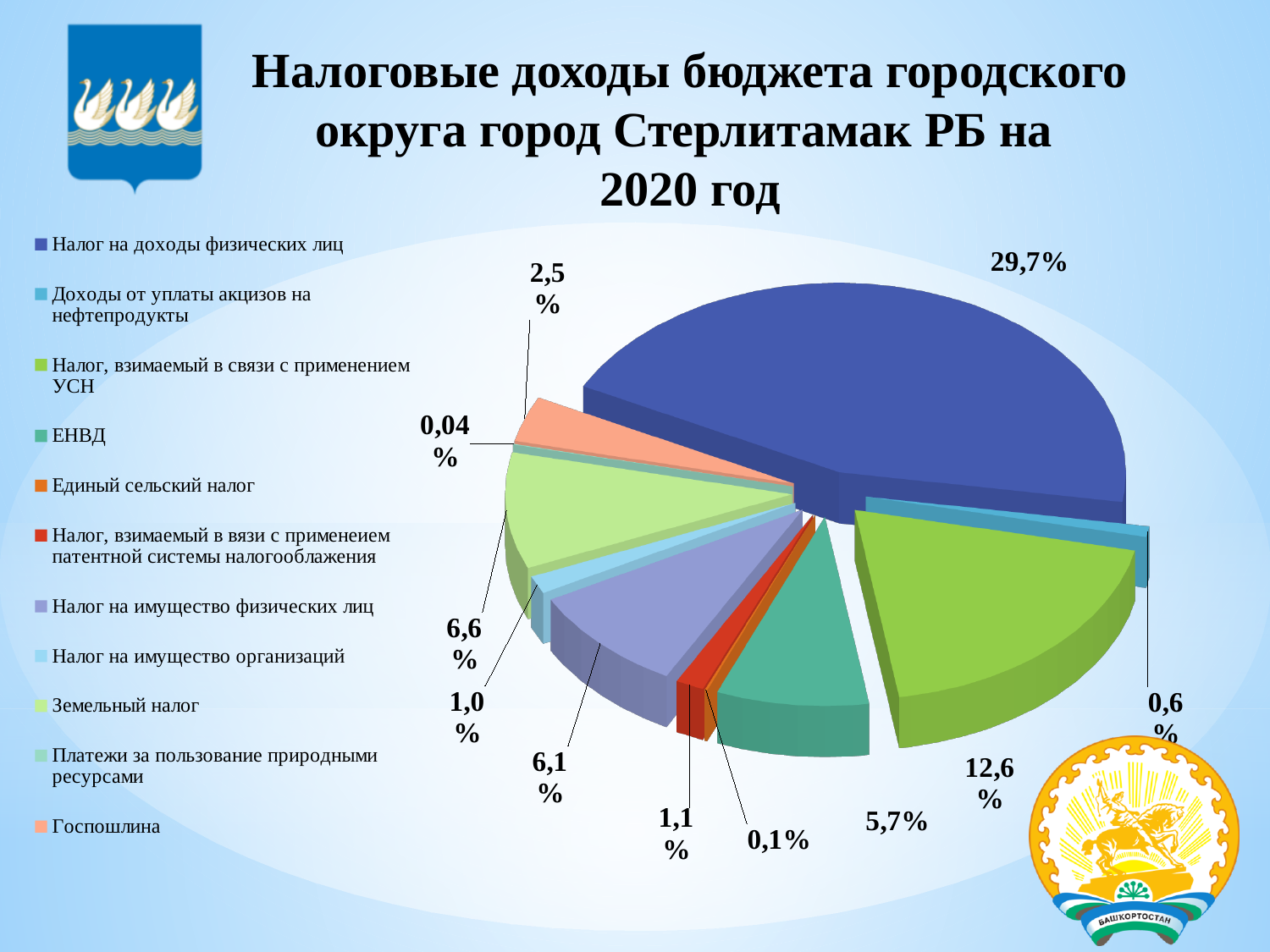
What share of the pie does "Налог на доходы физических лиц" have? 29,7% How many categories does the legend list? 11 What is the value shown for "Налог, взимаемый в связи с применением УСН"? 12,6% What is the value shown for "Госпошлина"? 2,5% What type of chart is shown on the slide? pie chart Which category has the largest slice of the pie? Налог на доходы физических лиц What is the value shown for "ЕНВД"? 5,7% What is the title of the chart on the slide? Налоговые доходы бюджета городского округа город Стерлитамак РБ на 2020 год Which is larger: the slice for "Налог на имущество физических лиц" or the slice for "Земельный налог"? Земельный налог What is the difference between the values for "Налог на доходы физических лиц" and "Налог, взимаемый в связи с применением УСН"? 17,1% What is the value shown for "Земельный налог"? 6,6% Which category has the smallest slice of the pie? Платежи за пользование природными ресурсами